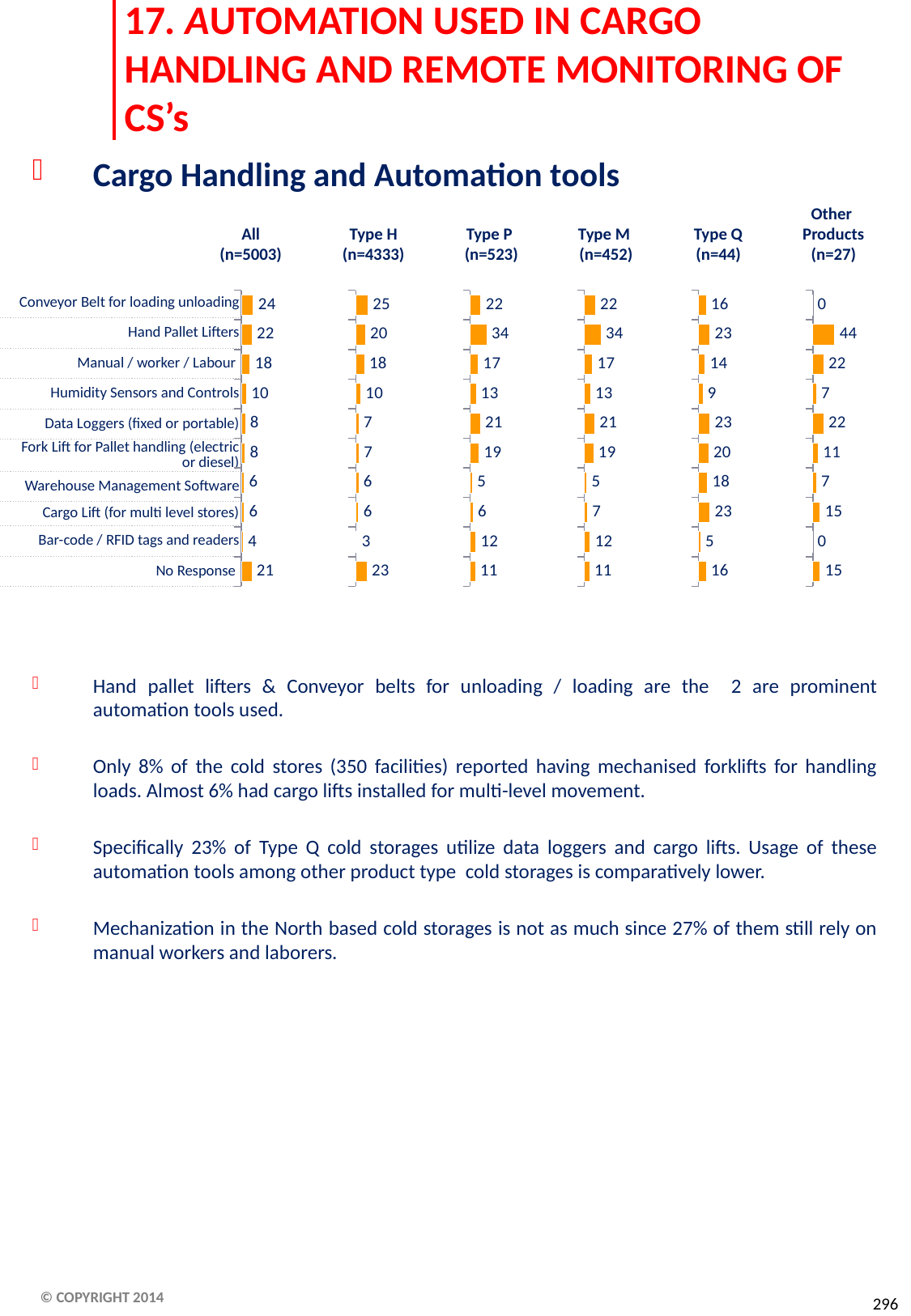
In the Type Q (n=44) chart, what is the value for Data Loggers (fixed or portable)? 23 What kind of chart is used for the Type H (n=4333) data? Bar chart In the Other Products (n=27) chart, what is the difference between Manual / worker / Labour and Fork Lift for Pallet handling (electric or diesel)? 11 In the Type P (n=523) chart, which category has the highest value? Hand Pallet Lifters In the Type H (n=4333) chart, which category has the lowest value? Bar-code / RFID tags and readers What is the sample size shown in the header of the Type Q chart? n=44 How many categories are plotted in the All (n=5003) chart? 10 In the All (n=5003) chart, what is the value for Conveyor Belt for loading unloading? 24 In the Type M (n=452) chart, what is the value for Cargo Lift (for multi level stores)? 7 In the Type Q (n=44) chart, which is larger: Warehouse Management Software or Humidity Sensors and Controls? Warehouse Management Software In the All (n=5003) chart, what is the difference between Conveyor Belt for loading unloading and Hand Pallet Lifters? 2 In the Other Products (n=27) chart, what is the value for Hand Pallet Lifters? 44